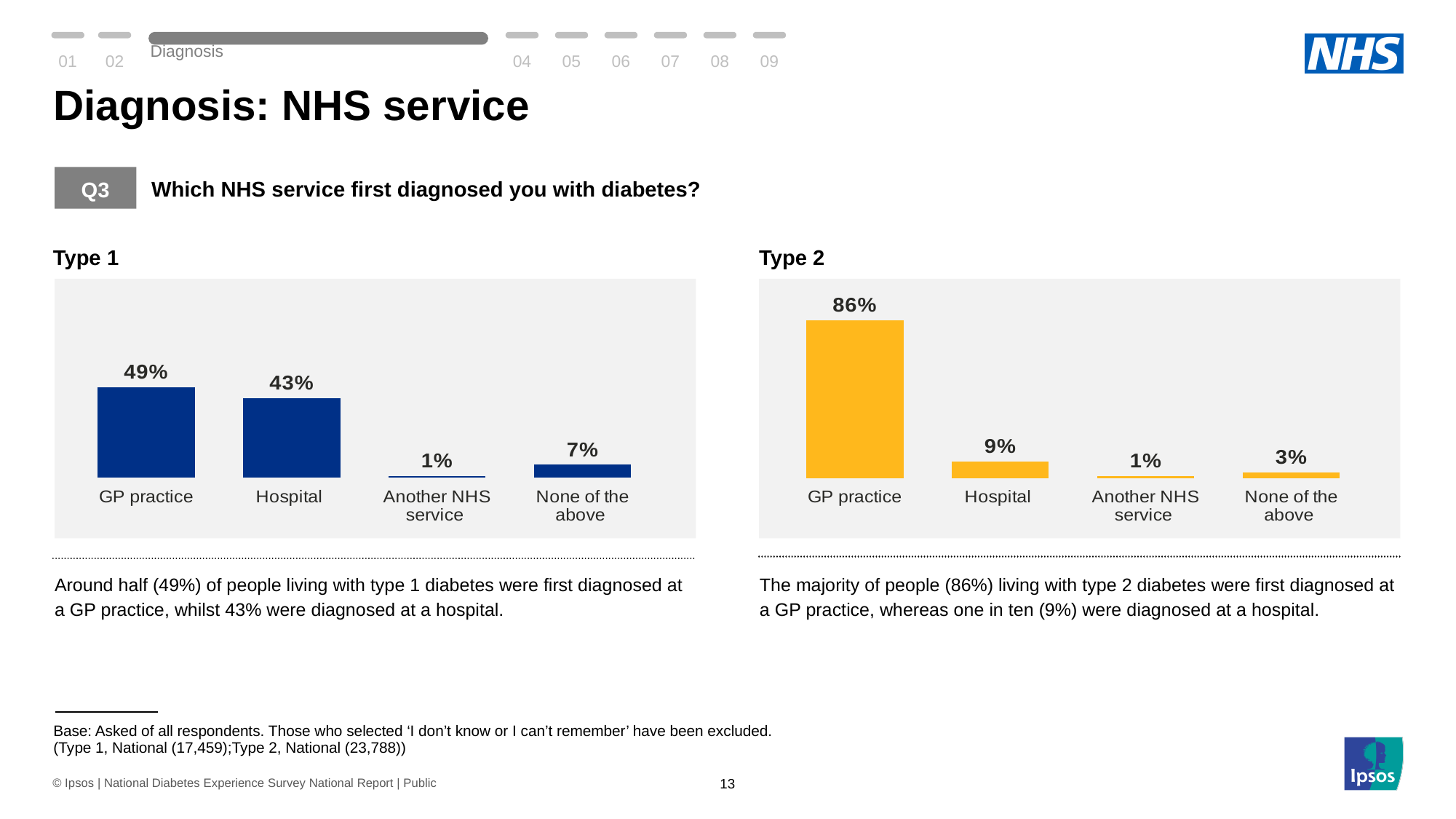
Which is larger in the Type 2 chart: None of the above or Another NHS service? None of the above What is the value for Another NHS service in the Type 2 chart? 1% In the Type 2 chart, what is the difference between the GP practice and Hospital values? 77% How many categories are shown in the Type 1 chart? 4 In the Type 2 chart, what percentage were first diagnosed at a hospital? 9% In the Type 1 chart, what is the value for None of the above? 7% What kind of chart is the Type 2 chart? Bar chart In the Type 2 chart, which category has the highest value? GP practice In the Type 1 chart, what is the difference between the GP practice and Hospital values? 6% In the Type 1 chart, what percentage were first diagnosed at a GP practice? 49% In the Type 1 chart, which category has the lowest value? Another NHS service What colour are the bars in the Type 2 chart? Yellow